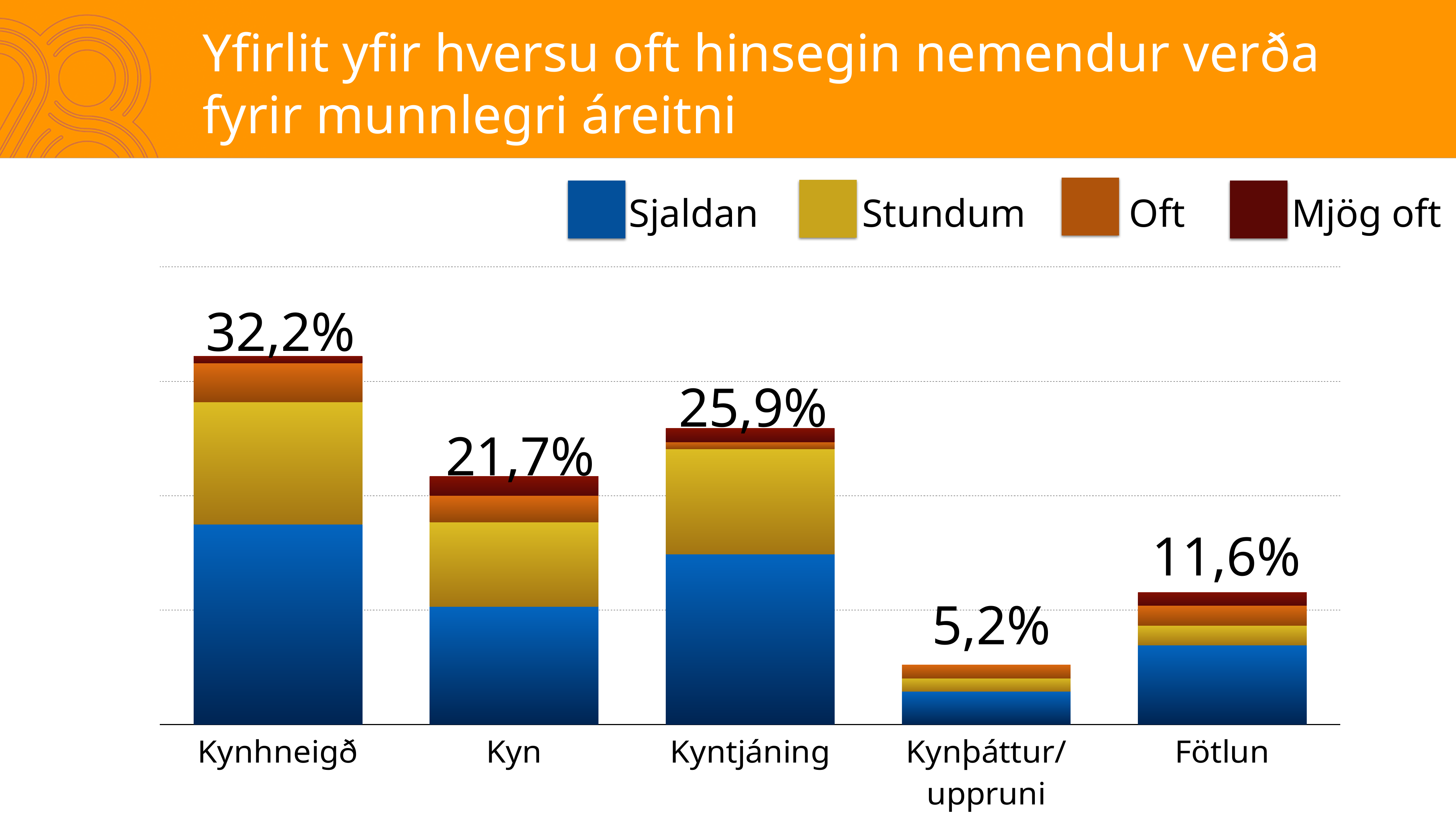
What is the total value shown for Kynhneigð? 32,2% Which series is shown in blue according to the legend? Sjaldan Which has a larger total, Kyn or Kyntjáning? Kyntjáning What is the total value shown for Kynþáttur/uppruni? 5,2% What is the total value shown for Fötlun? 11,6% Which category has the lowest total value? Kynþáttur/uppruni What is the difference between the total for Kynhneigð and the total for Kyn? 10,5% How many series does the legend list? 4 What kind of chart is shown on the slide? Stacked bar chart Which category has the highest total value? Kynhneigð How many categories are shown on the x axis? 5 What is the difference between the total for Kyntjáning and the total for Kynþáttur/uppruni? 20,7%